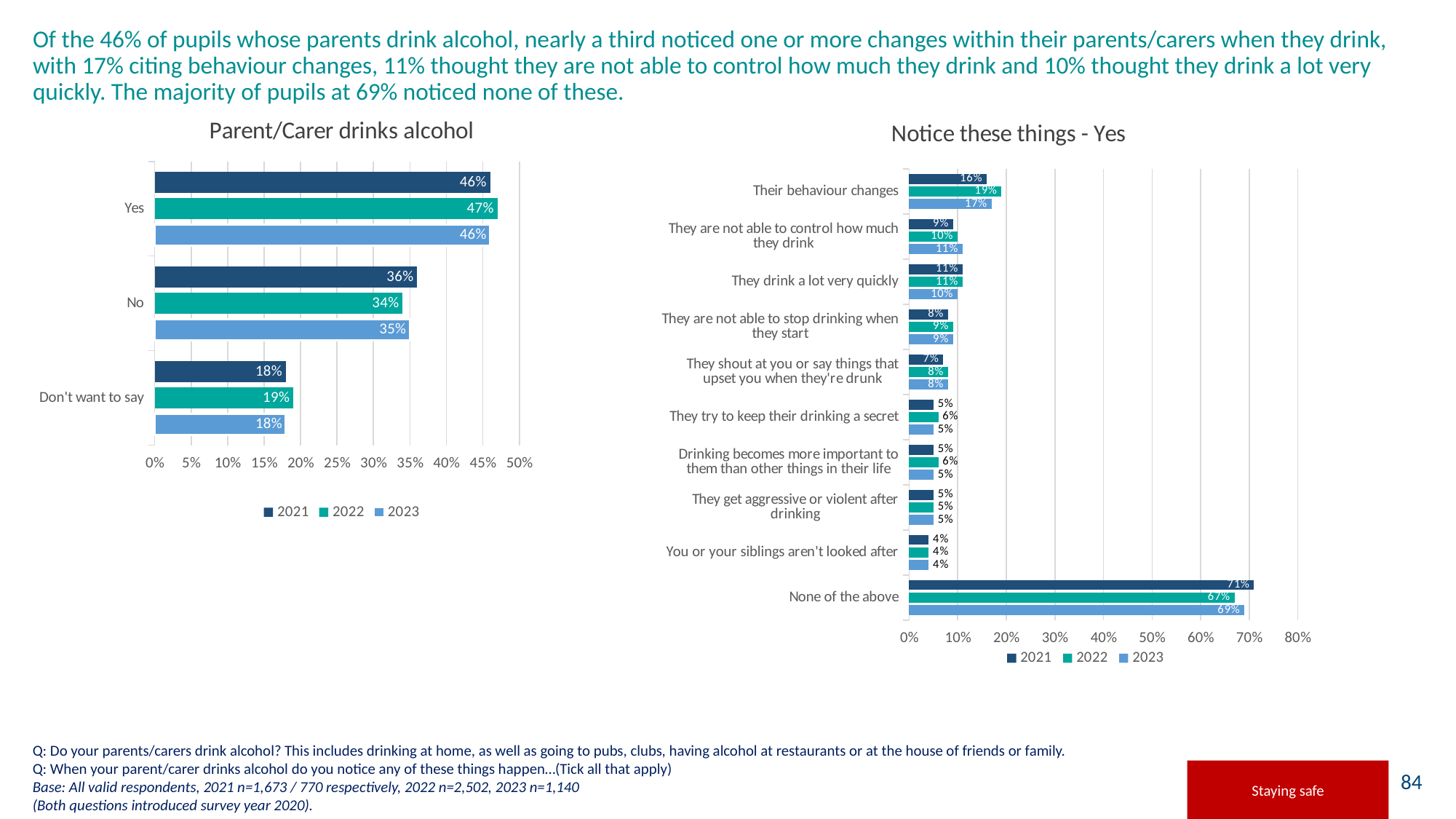
In the 'Notice these things - Yes' chart, how many categories are shown on the y axis? 10 In the 'Parent/Carer drinks alcohol' chart, what is the value for 'Don't want to say' in 2023? 18% In the 'Parent/Carer drinks alcohol' chart, what is the value for 'Yes' in 2022? 47% In the 'Parent/Carer drinks alcohol' chart, what is the difference between the 'Yes' and 'No' values for 2022? 13% In the 'Notice these things - Yes' chart, which category has the lowest values across all years? You or your siblings aren't looked after In the 'Notice these things - Yes' chart, what is the 2021 value for 'None of the above'? 71% In the 'Notice these things - Yes' chart, what is the 2023 value for 'Their behaviour changes'? 17% In the 'Parent/Carer drinks alcohol' chart, how many series does the legend list? 3 In the 'Parent/Carer drinks alcohol' chart, which category has the highest value in 2023? Yes In the 'Notice these things - Yes' chart, is the 2022 value for 'Their behaviour changes' larger or smaller than the 2021 value? larger In the 'Parent/Carer drinks alcohol' chart, what is the value for 'No' in 2021? 36% What kind of chart is the 'Notice these things - Yes' chart? bar chart